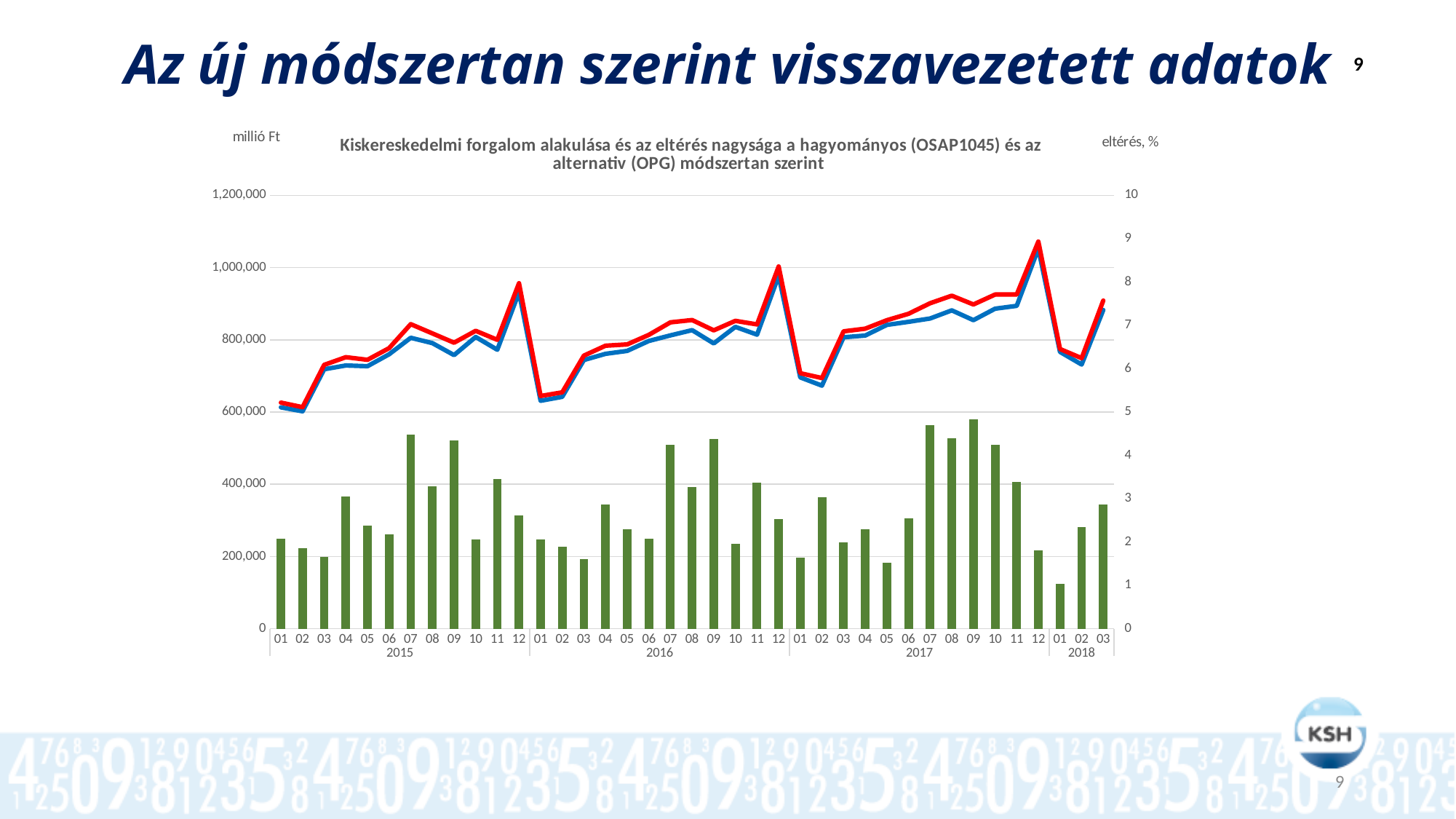
How many years are labelled on the x axis of the chart? 4 In which month is the green bar (eltérés, %) lowest? 01 2018 Is the green bar for 01 2018 greater or less than 2%? less Do the red and blue lines rise or fall from 01 2015 to 07 2015? rise Is the blue line value for 02 2015 greater or less than 800,000 millió Ft? less How many monthly categories are plotted on the x axis in total? 39 In which month do the red and blue lines reach their highest peak? 12 2017 What kind of chart is shown on the slide? A combined line and bar chart Is the value of the red line in 12 2017 greater or less than 1,000,000 millió Ft? greater What is the label of the right-hand vertical axis? eltérés, % Which is larger, the green bar for 09 2017 or the green bar for 01 2018? 09 2017